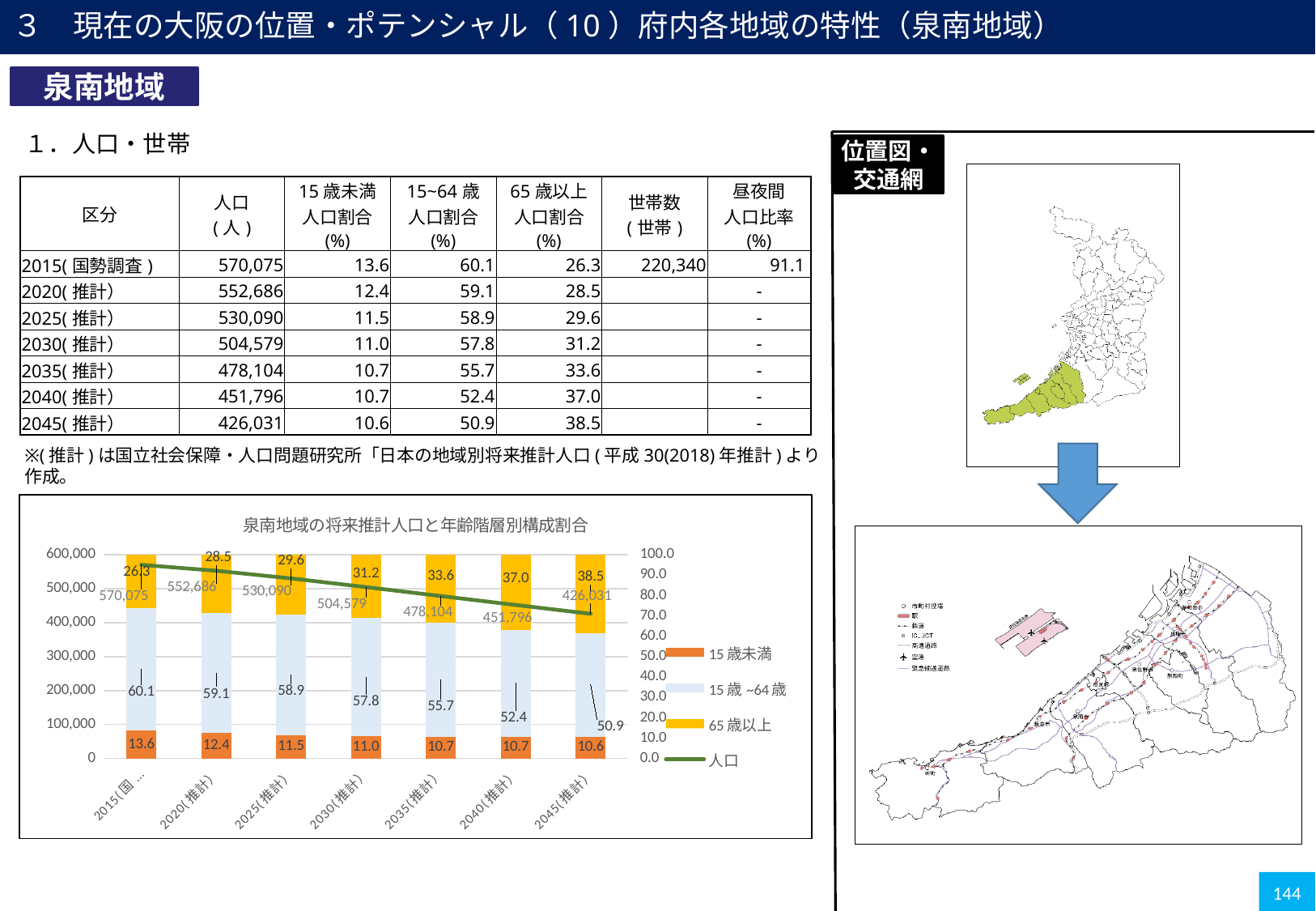
What is the 15歳~64歳 share shown for 2020(推計) in the chart? 59.1 Which is larger in the chart: the 15歳~64歳 share for 2025(推計) or for 2040(推計)? 2025(推計) Which year has the highest 65歳以上 share in the chart? 2045(推計) How many series does the chart legend list? 4 What is the 人口 value plotted for 2030(推計) in the chart? 504,579 What is the title of the chart on the slide? 泉南地域の将来推計人口と年齢階層別構成割合 Does the 人口 line in the chart rise or fall from 2015 to 2045? Fall Which year has the lowest 15歳未満 share in the chart? 2045(推計) What is the 65歳以上 share shown for 2045(推計) in the chart? 38.5 What type of chart is shown on the slide? Stacked bar chart with a line How many year categories are plotted along the x axis of the chart? 7 What is the difference between the 人口 values for 2015(国勢調査) and 2045(推計) in the chart? 144,044